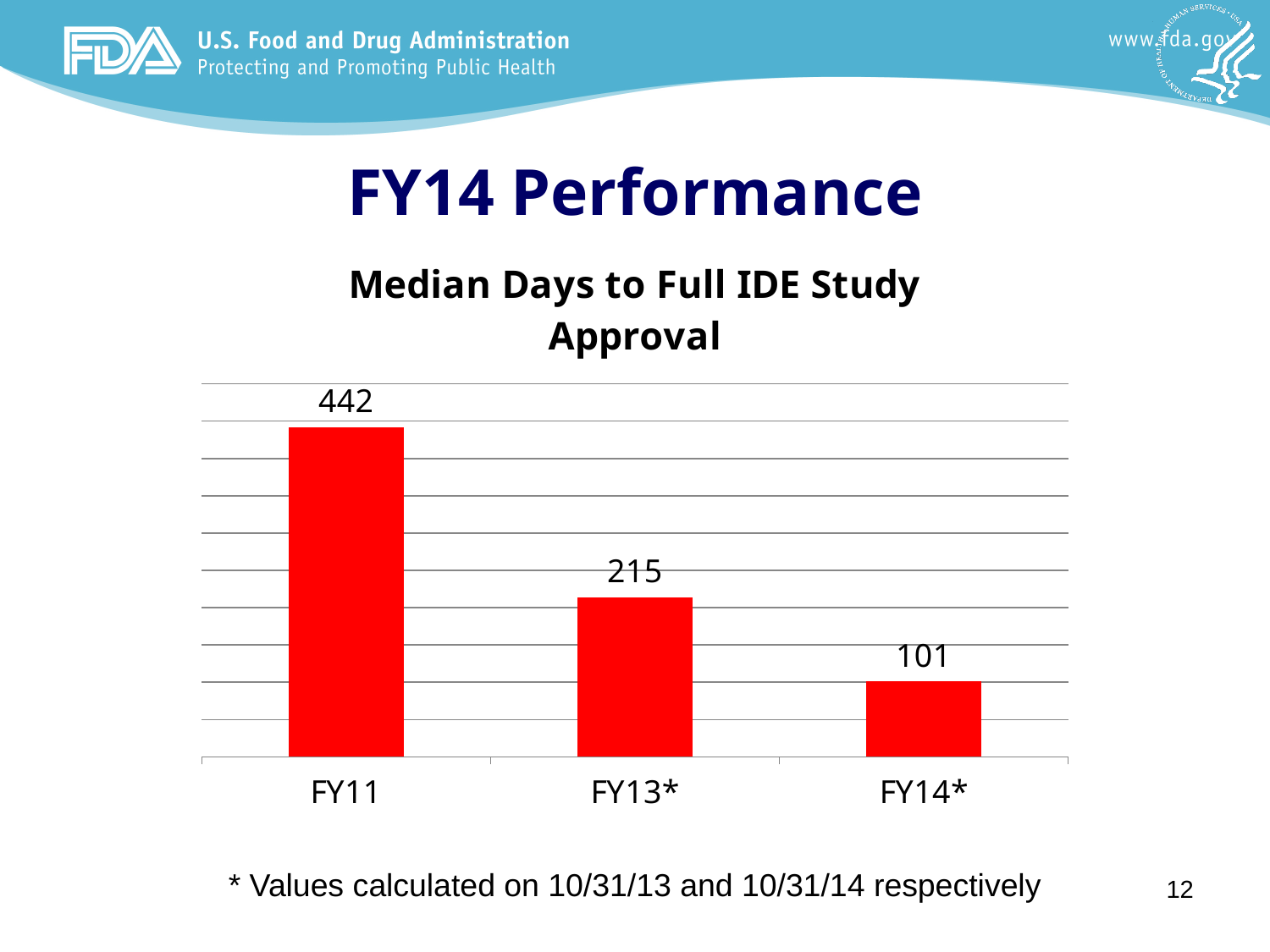
What is the title of the chart? Median Days to Full IDE Study Approval Which has a larger value, FY13* or FY14*? FY13* How many fiscal years are shown in the chart? 3 Which fiscal year has the lowest median days to full IDE study approval? FY14* What kind of chart is shown on the slide? Bar chart What is the median days to full IDE study approval for FY13*? 215 Which fiscal year has the highest median days to full IDE study approval? FY11 What is the difference in median days between FY13* and FY14*? 114 What is the median days to full IDE study approval for FY11? 442 Do the values rise or fall from FY11 to FY14*? Fall What is the median days to full IDE study approval for FY14*? 101 What is the difference in median days between FY11 and FY14*? 341